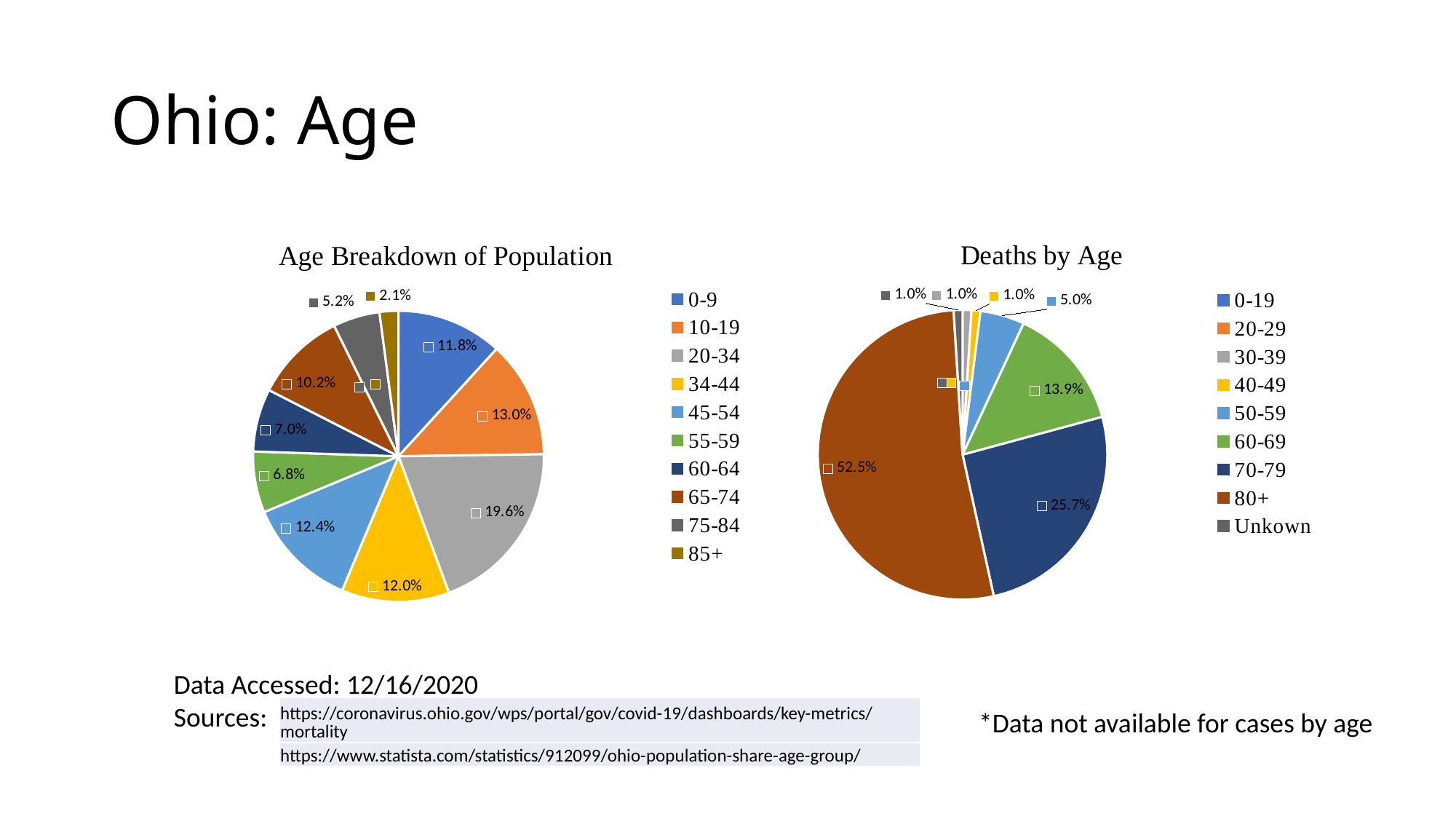
In the Age Breakdown of Population chart, what is the difference between the shares for 45-54 and 55-59? 5.6% In the Age Breakdown of Population chart, how many age groups does the legend list? 10 In the Deaths by Age chart, what share of deaths is in the 80+ age group? 52.5% In the Deaths by Age chart, which age group accounts for the largest share of deaths? 80+ What kind of charts are shown on the slide? Pie charts In the Deaths by Age chart, what share of deaths is in the 60-69 age group? 13.9% In the Deaths by Age chart, what is the combined share of the 70-79 and 80+ age groups? 78.2% In the Age Breakdown of Population chart, what share of the population is aged 20-34? 19.6% In the Deaths by Age chart, which is larger, the share for 70-79 or the share for 50-59? 70-79 In the Age Breakdown of Population chart, which age group has the largest share? 20-34 In the Age Breakdown of Population chart, what share of the population is aged 85+? 2.1% In the Age Breakdown of Population chart, which age group has the smallest share? 85+